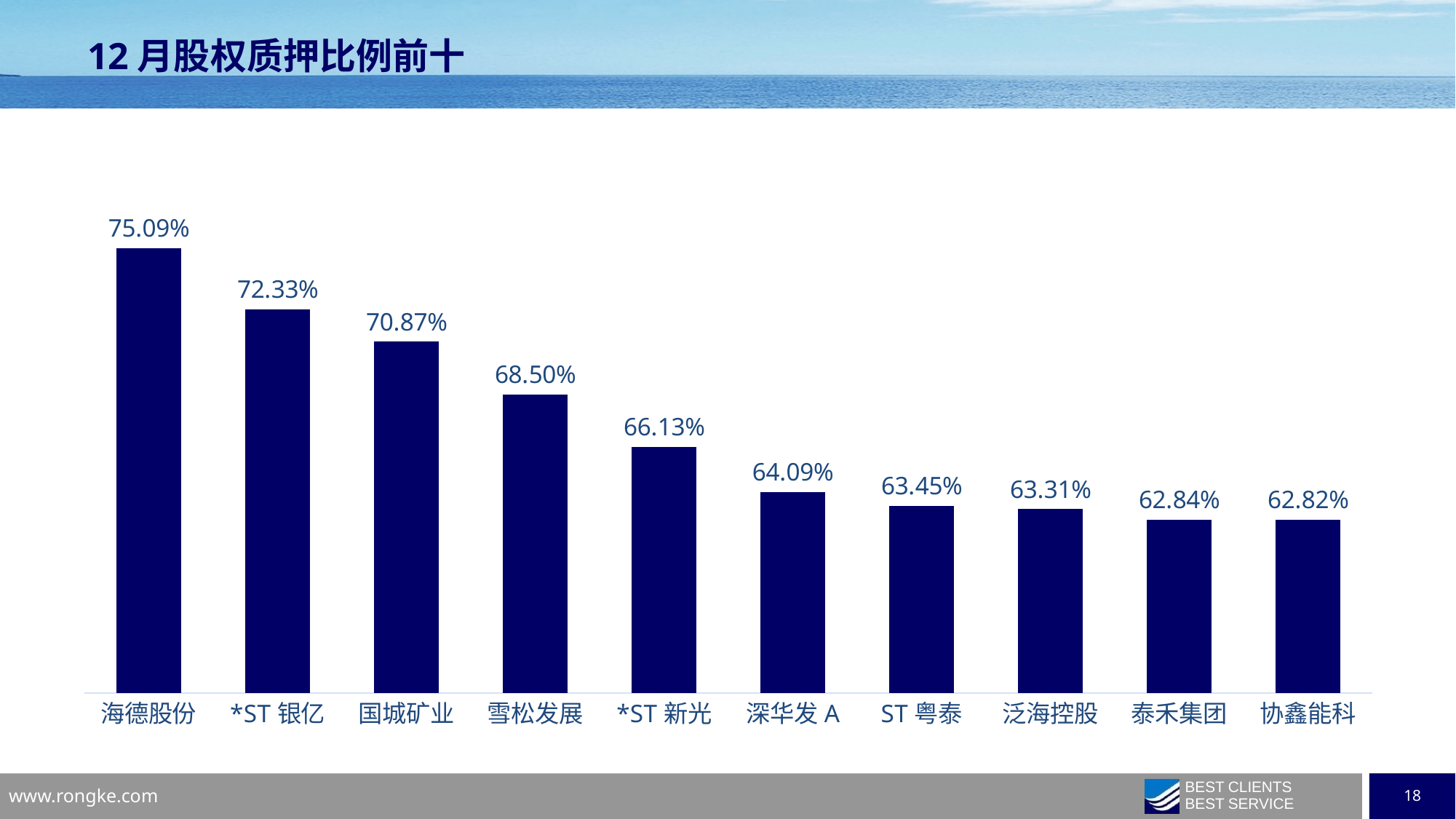
What is the value for 雪松发展? 68.50% How many categories are shown in the chart? 10 What is the difference between the values for 国城矿业 and 深华发 A? 6.78% What kind of chart is shown on the slide? Bar chart What is the difference between the values for 海德股份 and *ST 银亿? 2.76% What is the value for 泛海控股? 63.31% Do the values rise or fall from left to right along the x axis? Fall Which category has the lowest value? 协鑫能科 Which category has the highest value? 海德股份 What is the value for 海德股份? 75.09% Which is larger, the value for *ST 新光 or the value for ST 粤泰? *ST 新光 What is the value for 协鑫能科? 62.82%